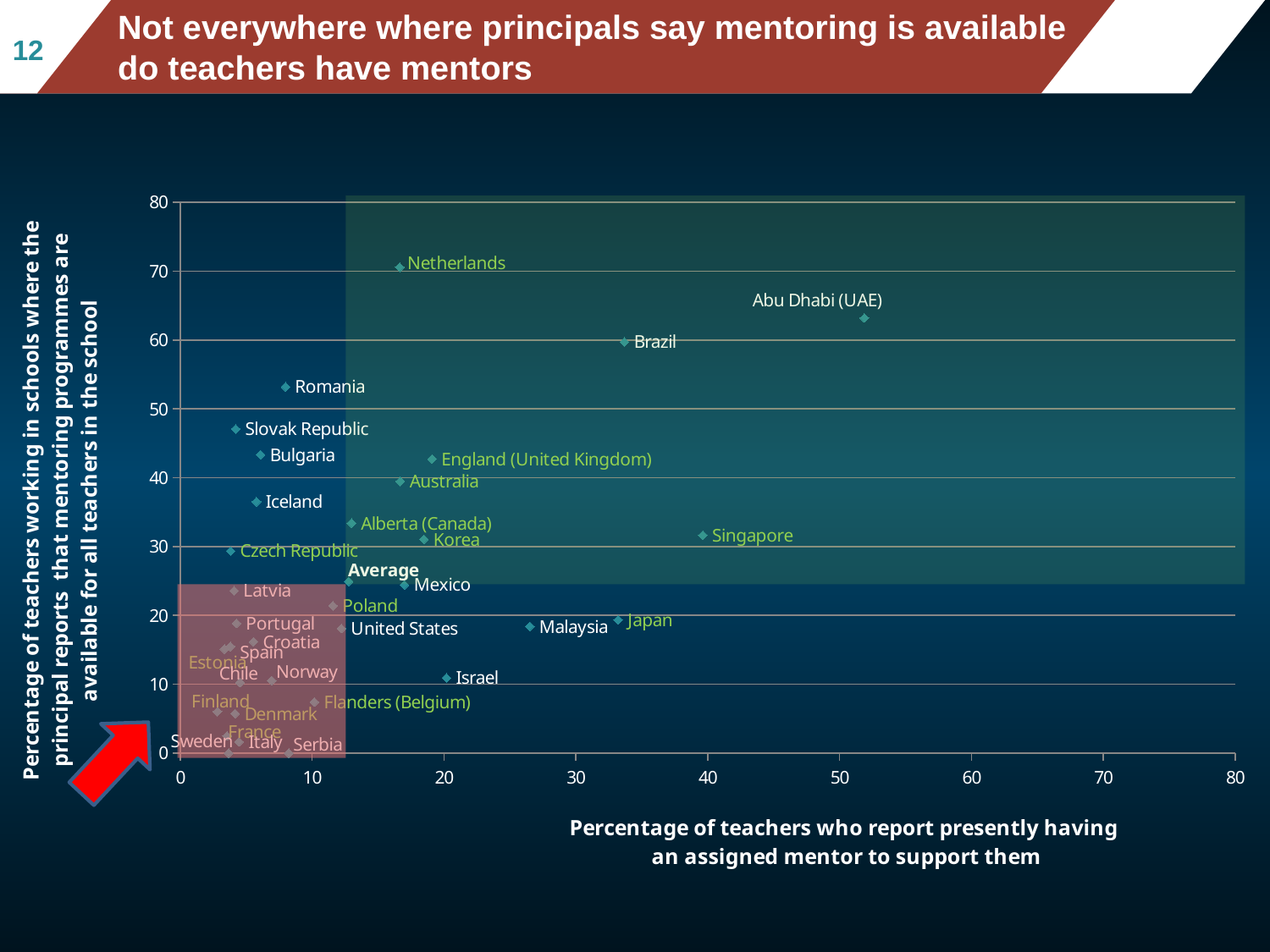
Is the vertical-axis value for Netherlands greater or less than 60? greater Which has a higher vertical-axis value, Romania or Iceland? Romania Is the vertical-axis value for Israel greater or less than 20? less Which country has the highest percentage of teachers working in schools where the principal reports mentoring programmes are available (vertical axis)? Netherlands Which country has the highest percentage of teachers who report presently having an assigned mentor (horizontal axis)? Abu Dhabi (UAE) Is the horizontal-axis value for Singapore greater or less than 30? greater What is the title of the horizontal axis? Percentage of teachers who report presently having an assigned mentor to support them Which has a higher horizontal-axis value, Abu Dhabi (UAE) or Brazil? Abu Dhabi (UAE) What kind of chart is shown on the slide? scatter chart Which has a higher vertical-axis value, Netherlands or Abu Dhabi (UAE)? Netherlands